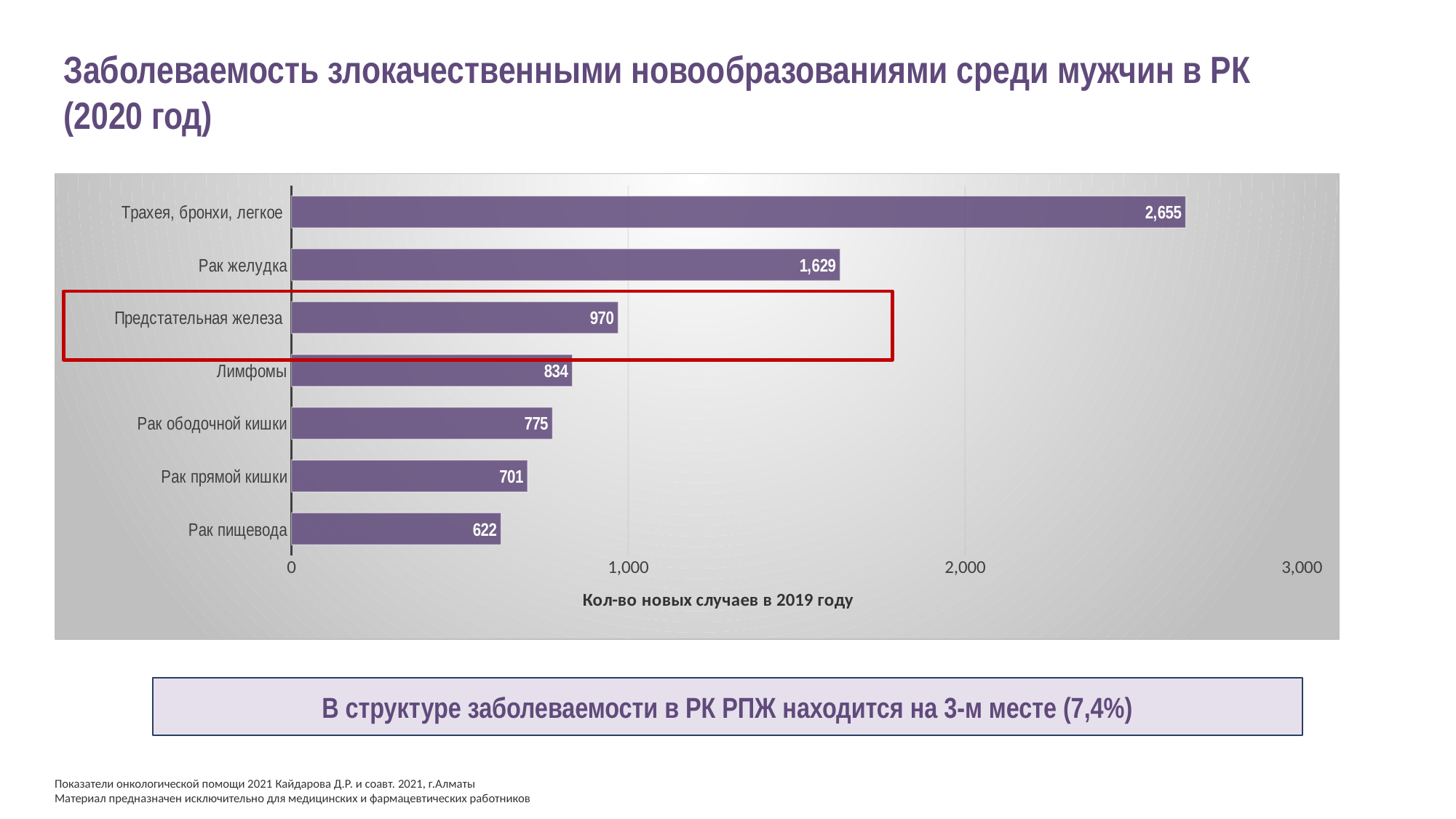
What is the value for Трахея, бронхи, легкое? 2,655 What is the label of the horizontal axis? Кол-во новых случаев в 2019 году What is the difference between the values for Трахея, бронхи, легкое and Рак желудка? 1,026 Which category has the highest value? Трахея, бронхи, легкое How many categories are shown in the chart? 7 Which is larger, the value for Рак прямой кишки or the value for Рак ободочной кишки? Рак ободочной кишки What is the value for Предстательная железа? 970 What is the value for Рак пищевода? 622 Is the value for Рак желудка greater or less than 1,000? greater What is the difference between the values for Лимфомы and Рак ободочной кишки? 59 What kind of chart is shown on the slide? bar chart Which category has the lowest value? Рак пищевода